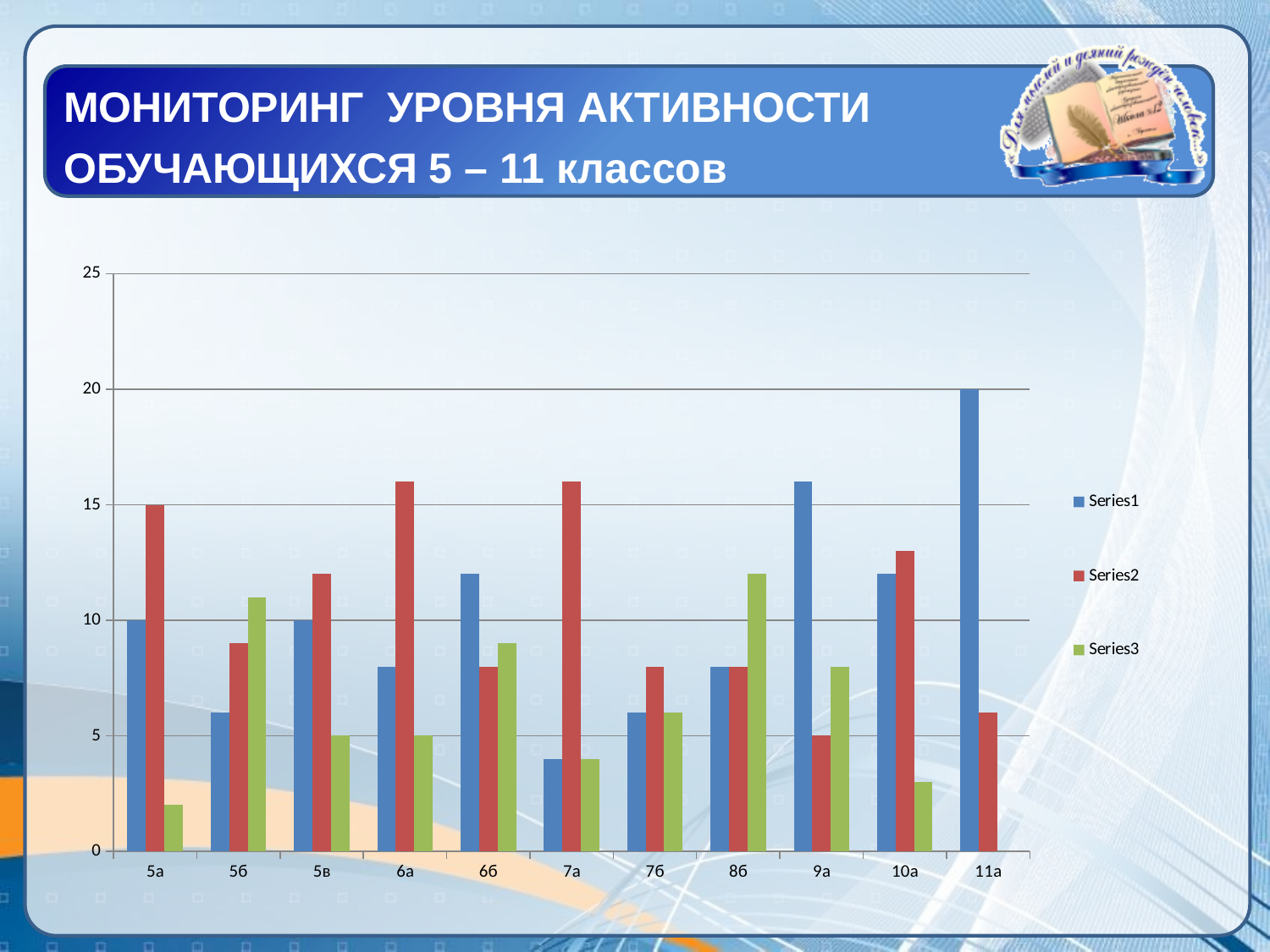
Is the value of Series2 for 6а greater or less than 15? greater What is the value of Series1 for 11а? 20 Which category has the highest Series1 value? 11а How many class categories are shown on the x axis? 11 Is the value of Series3 for 10а greater or less than 5? less For 5а, which is larger: Series1 or Series2? Series2 What is the value of Series1 for 5а? 10 What type of chart is shown on the slide? bar chart Which category has the lowest Series1 value? 7а How many series does the legend list? 3 What is the value of Series2 for 5а? 15 Which category has the highest Series3 value? 8б